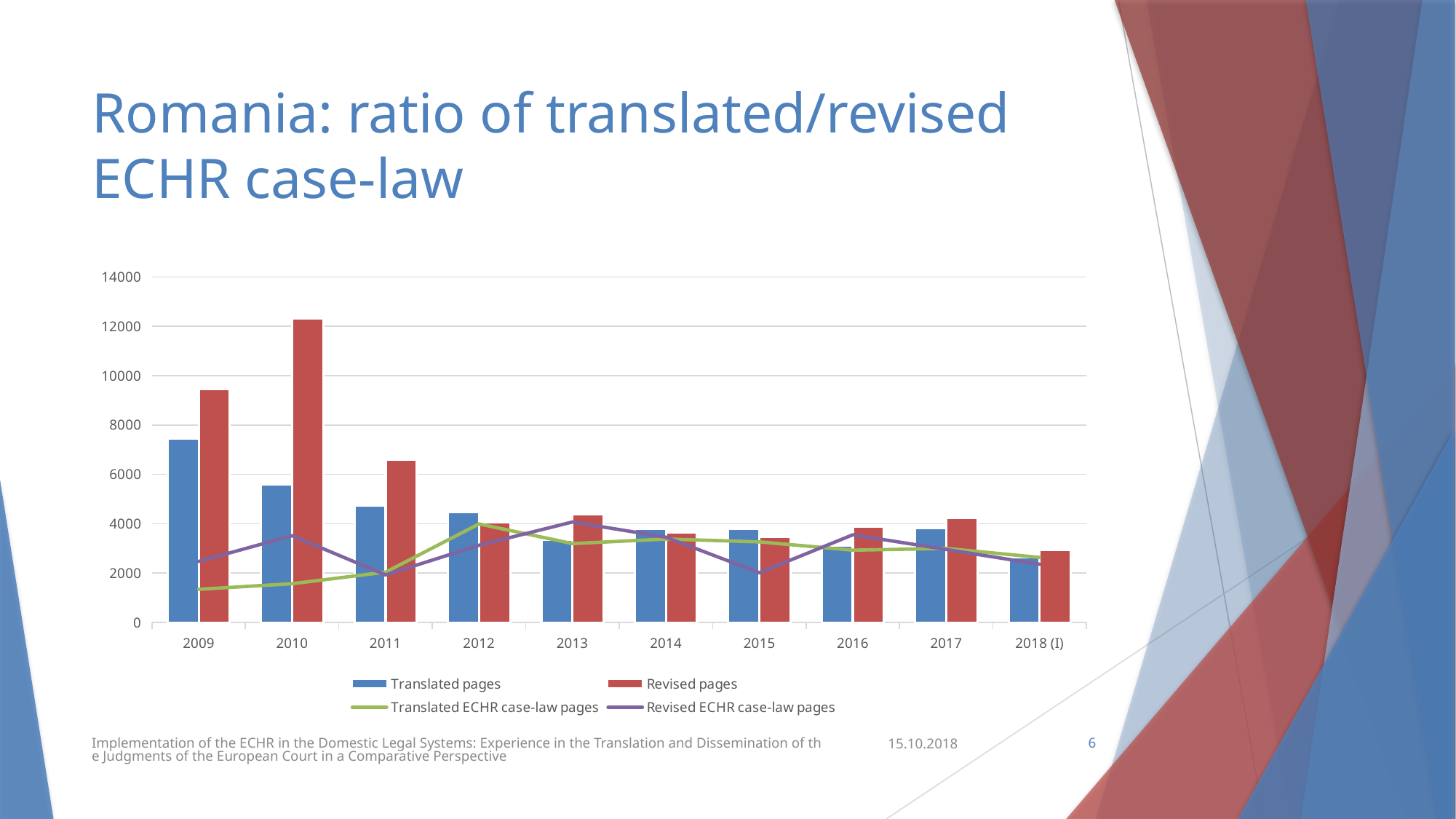
In which year is the Revised pages value lowest? 2018 (I) In 2013, which is larger: Translated pages or Revised pages? Revised pages How many years (categories) are shown on the x axis? 10 In which year is the Translated pages value highest? 2009 Is the Translated pages value for 2009 greater or less than 8000? less Is the Translated ECHR case-law pages value for 2009 greater or less than 2000? less What kind of chart is used to plot the Translated pages and Revised pages series? bar chart In which year is the Revised pages value highest? 2010 How many series does the legend list? 4 Do the Translated pages values rise or fall from 2009 to 2013? fall Is the Revised pages value for 2010 greater or less than 10000? greater In which year is the Translated pages value lowest? 2018 (I)